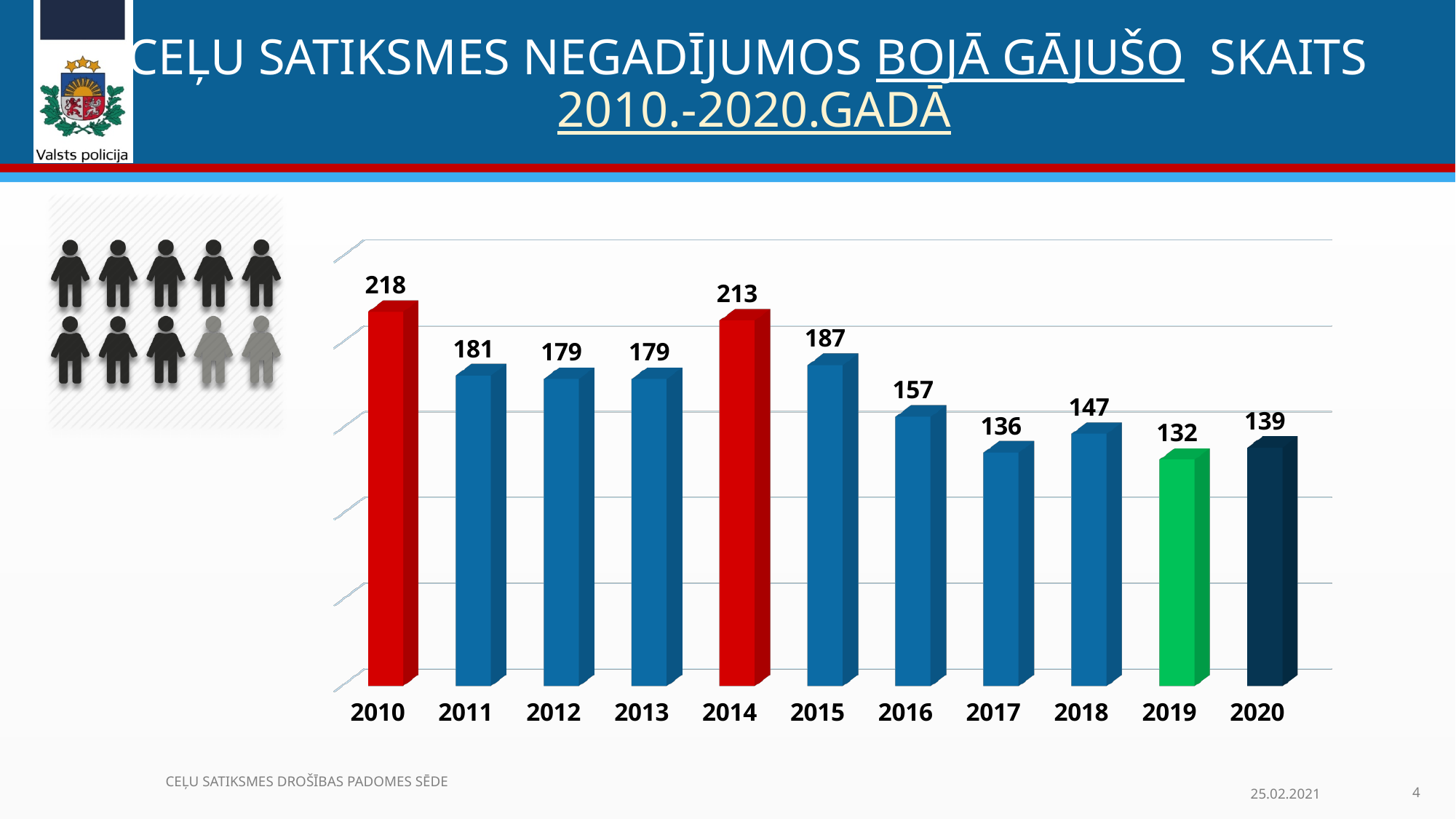
Which is larger, the value for 2018 or the value for 2017? 2018 What is the value for 2016? 157 Do the values generally rise or fall from 2014 to 2019? fall What is the difference between the values for 2014 and 2015? 26 How many years are shown on the x axis? 11 Which year has the highest value? 2010 What is the value for 2019? 132 What kind of chart is shown on the slide? bar chart What is the value for 2010? 218 What colour is the bar for 2019? green What is the difference between the values for 2010 and 2020? 79 Which year has the lowest value? 2019